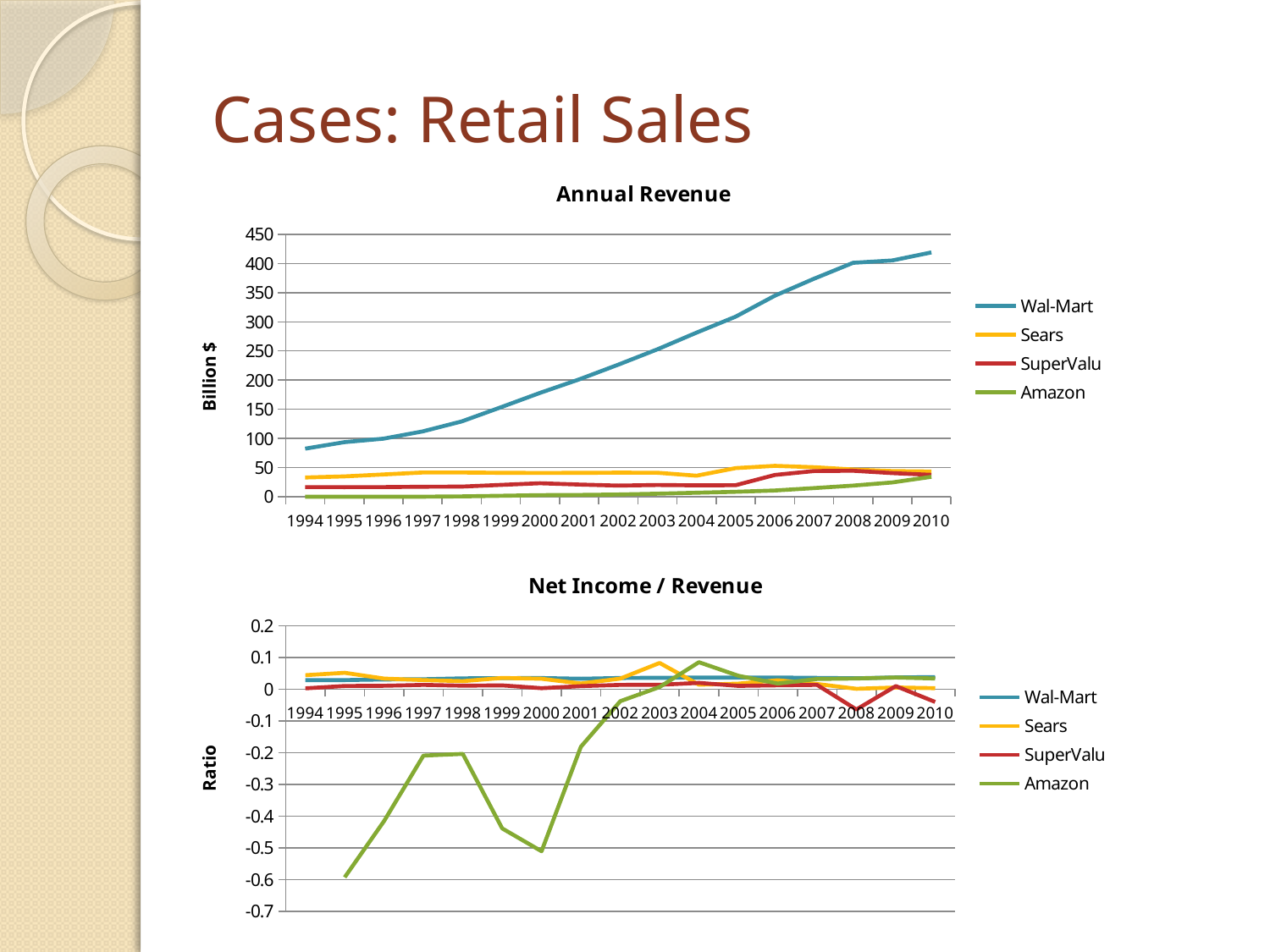
How many series does the legend of the Annual Revenue chart list? 4 In the Annual Revenue chart, is the value for Wal-Mart in 2010 greater or less than 400? greater How many years are shown on the x axis of the Annual Revenue chart? 17 In the Net Income / Revenue chart, which company has the lowest ratio in 1995? Amazon What is the y-axis label of the Annual Revenue chart? Billion $ In the Annual Revenue chart, which company has the lowest revenue in 1994? Amazon In the Annual Revenue chart, is the value for Wal-Mart in 1994 greater or less than 100? less In the Annual Revenue chart, which company has the highest revenue in 2010? Wal-Mart What kind of chart is the Annual Revenue chart? line chart In the Net Income / Revenue chart, is the value for Amazon in 1997 greater or less than -0.3? greater In the Annual Revenue chart, does Wal-Mart's revenue rise or fall from 1994 to 2010? rise